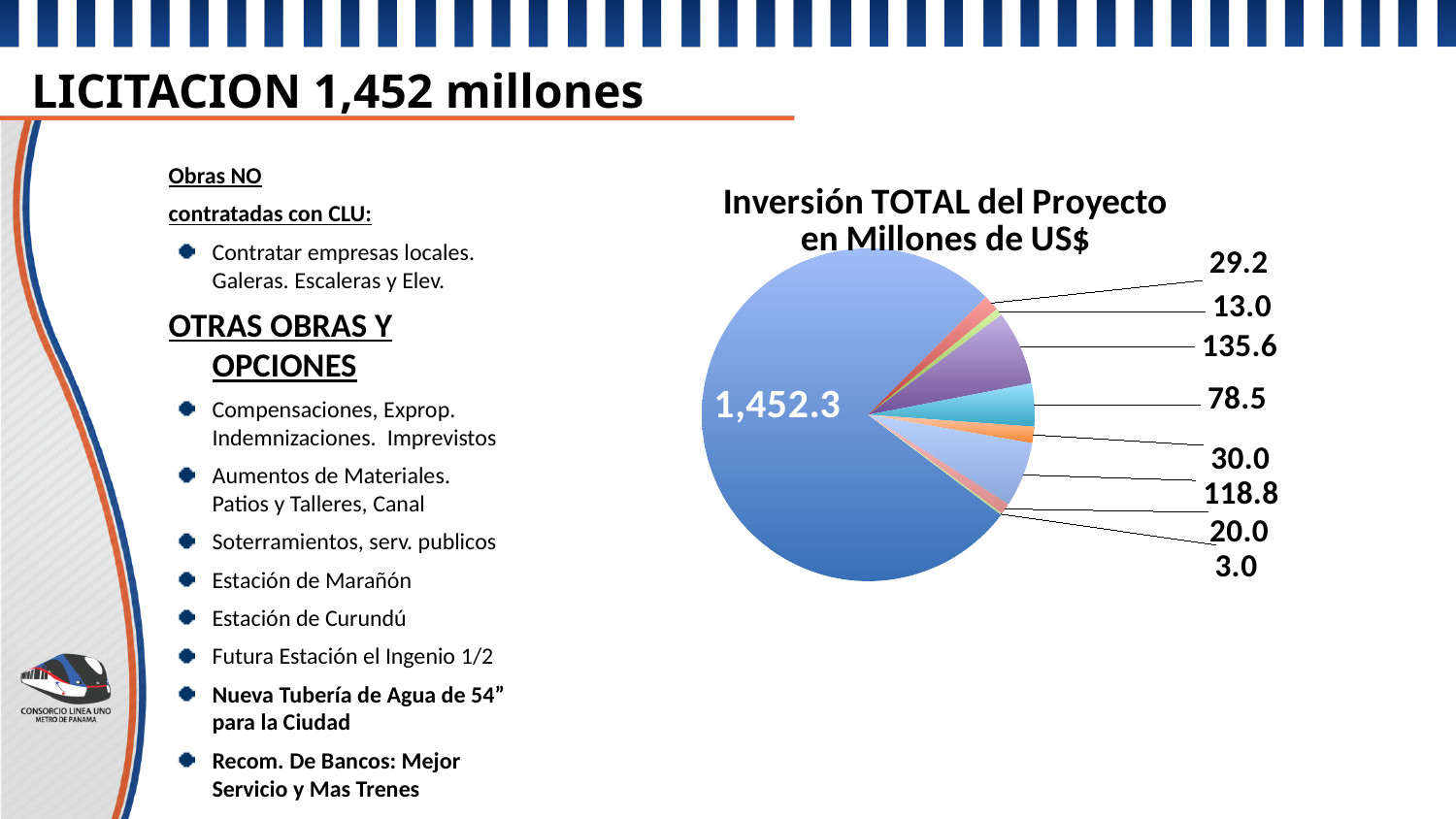
What is the title of the pie chart? Inversión TOTAL del Proyecto en Millones de US$ What is the difference between the slices labeled 30.0 and 20.0? 10.0 What kind of chart is shown on the slide? pie chart Which is larger in the pie chart, the slice labeled 29.2 or the slice labeled 13.0? 29.2 What is the value of the largest slice in the pie chart? 1,452.3 What is the difference between the largest slice (1,452.3) and the slice labeled 78.5? 1,373.8 What is the value of the smallest slice in the pie chart? 3.0 What is the value of the second-largest slice in the pie chart? 135.6 What is the sum of the slices labeled 13.0, 20.0 and 3.0? 36.0 What is the difference between the slices labeled 135.6 and 118.8? 16.8 How many slices are labeled in the pie chart? 9 Which is larger in the pie chart, the slice labeled 135.6 or the slice labeled 118.8? 135.6